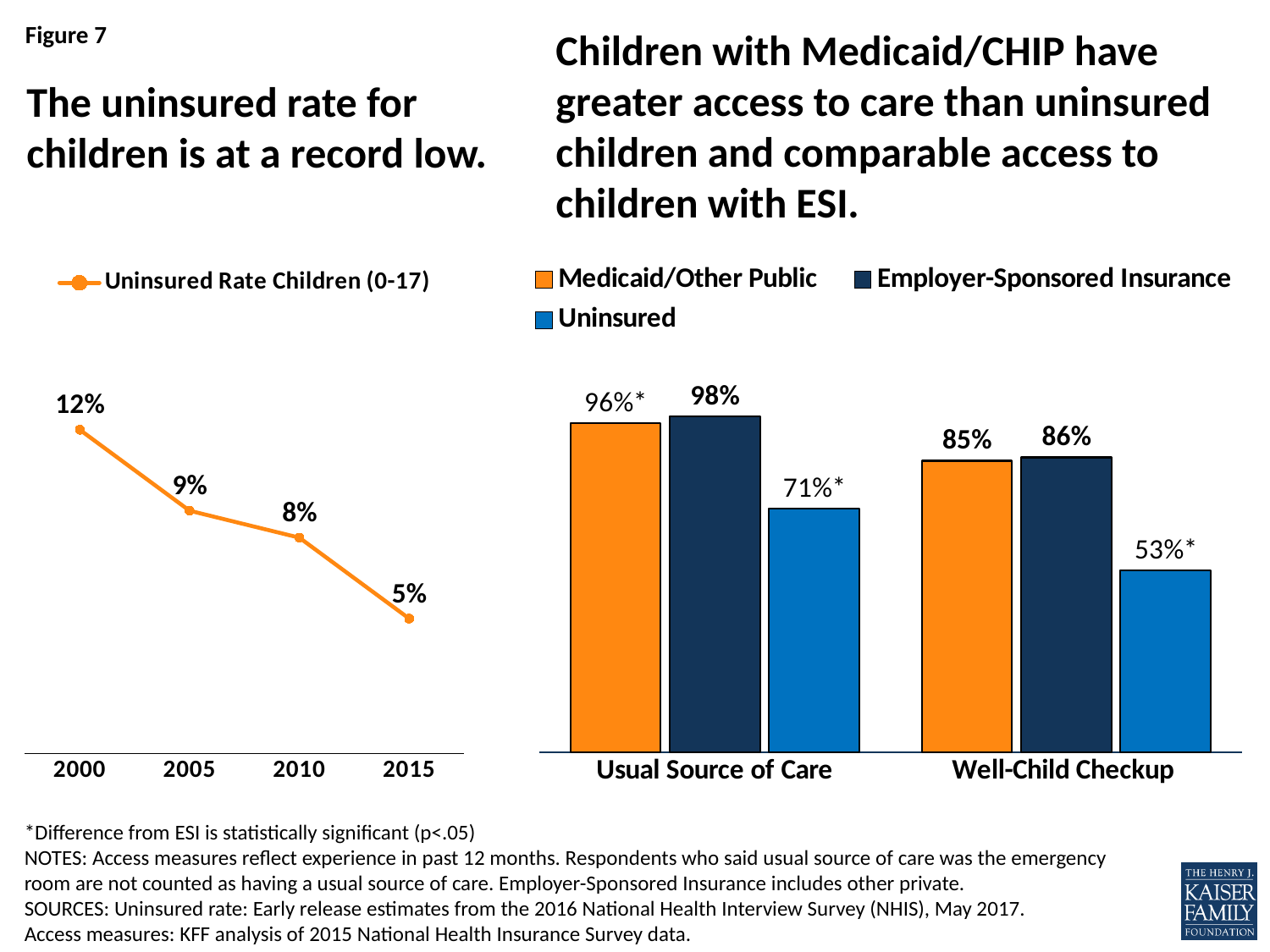
In the right chart (access to care), which coverage group has the lowest value for Usual Source of Care? Uninsured In the left chart (uninsured rate for children), how many years are plotted? 4 In the right chart (access to care), what share of children with Medicaid/Other Public have a usual source of care? 96%* In the left chart (uninsured rate for children), what was the uninsured rate for children in 2015? 5% In the left chart (uninsured rate for children), what was the uninsured rate for children in 2000? 12% In the right chart (access to care), what is the difference between Employer-Sponsored Insurance and Uninsured for Well-Child Checkup? 33 percentage points In the right chart (access to care), what share of uninsured children had a well-child checkup? 53%* In the left chart (uninsured rate for children), does the uninsured rate rise or fall from 2000 to 2015? fall In the left chart (uninsured rate for children), which year has the lowest uninsured rate? 2015 In the left chart (uninsured rate for children), by how many percentage points did the uninsured rate fall from 2000 to 2015? 7 percentage points In the right chart (access to care), how many series does the legend list? 3 What kind of chart is the left chart showing the uninsured rate for children? line chart